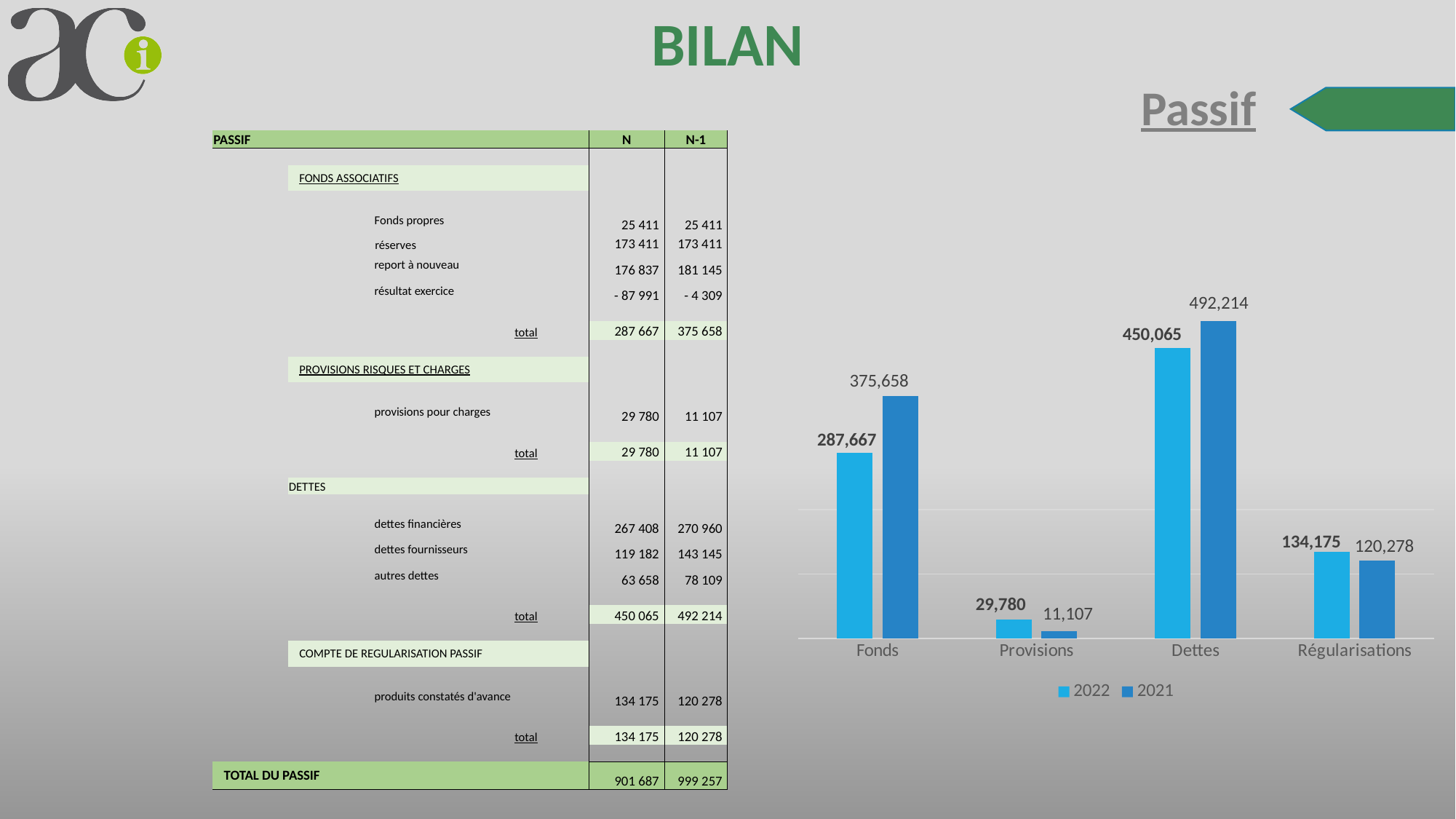
What kind of chart is shown on the slide? Bar chart Which is larger for Régularisations, the 2022 value or the 2021 value? 2022 Which category has the lowest value in the 2022 series? Provisions What is the difference between the 2022 and 2021 values for Provisions? 18,673 What is the value for Dettes in the 2022 series? 450,065 How many categories are shown on the x axis of the chart? 4 What is the value for Fonds in the 2021 series? 375,658 What is the difference between the 2021 and 2022 values for Fonds? 87,991 Which category has the highest value in the 2021 series? Dettes How many series does the chart's legend list? 2 What is the value for Provisions in the 2021 series? 11,107 What is the value for Régularisations in the 2022 series? 134,175